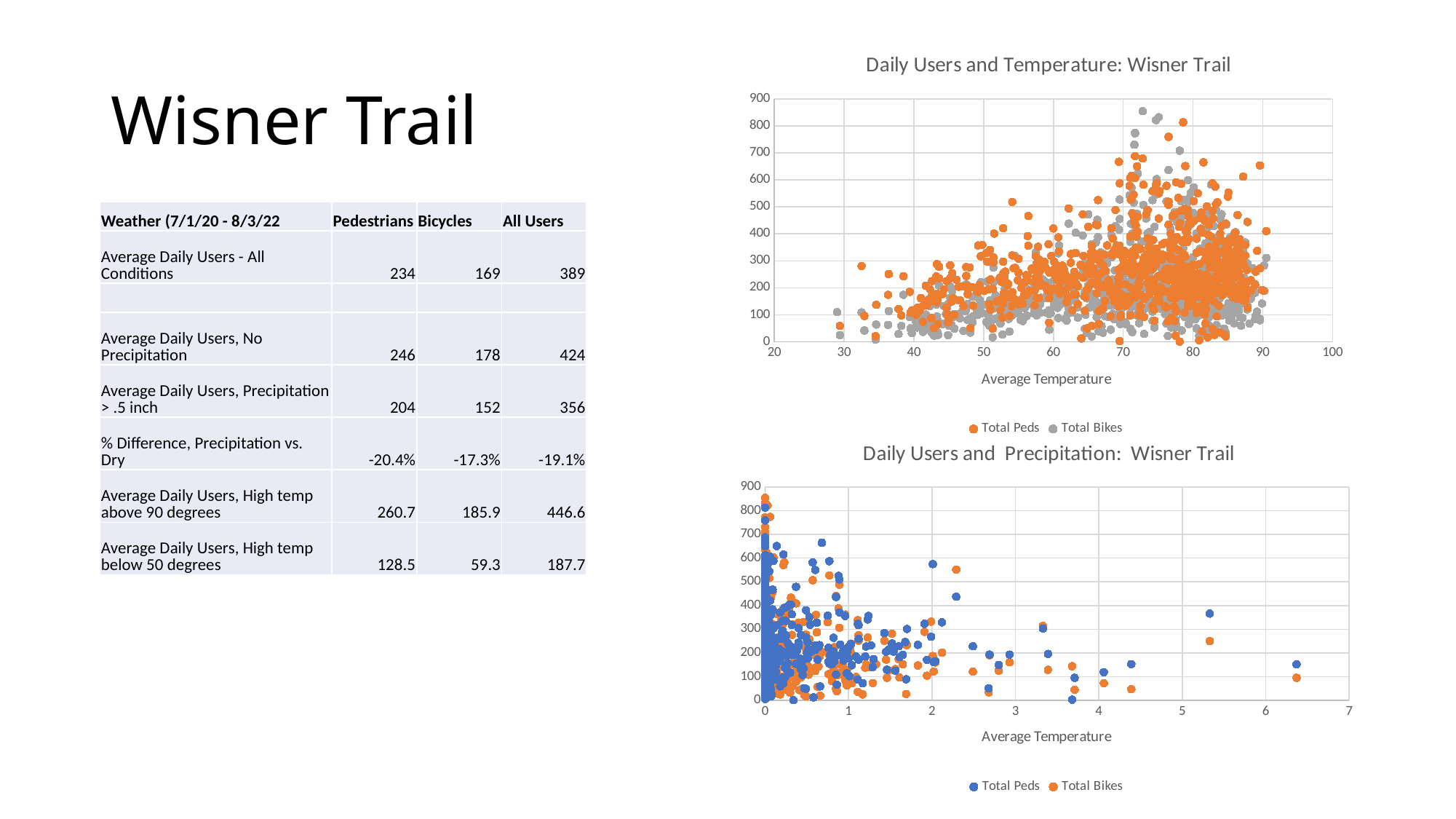
How many series does the legend list in the chart titled "Daily Users and Temperature: Wisner Trail"? 2 In the chart titled "Daily Users and Precipitation: Wisner Trail", is the point plotted near x = 6.4 for Total Peds greater or less than 200? less What kind of chart is the chart titled "Daily Users and Temperature: Wisner Trail"? scatter chart In the chart titled "Daily Users and Temperature: Wisner Trail", is the highest plotted point greater or less than 800? greater In the chart titled "Daily Users and Temperature: Wisner Trail", do the Total Peds values generally rise or fall as average temperature increases from 40 to 80? rise In the chart titled "Daily Users and Temperature: Wisner Trail", what is the x-axis label? Average Temperature How many series does the legend list in the chart titled "Daily Users and Precipitation: Wisner Trail"? 2 What kind of chart is the chart titled "Daily Users and Precipitation: Wisner Trail"? scatter chart In the chart titled "Daily Users and Temperature: Wisner Trail", what is the maximum value shown on the y-axis? 900 In the chart titled "Daily Users and Precipitation: Wisner Trail", is the highest plotted point greater or less than 800? greater In the chart titled "Daily Users and Temperature: Wisner Trail", what are the two series named in the legend? Total Peds and Total Bikes